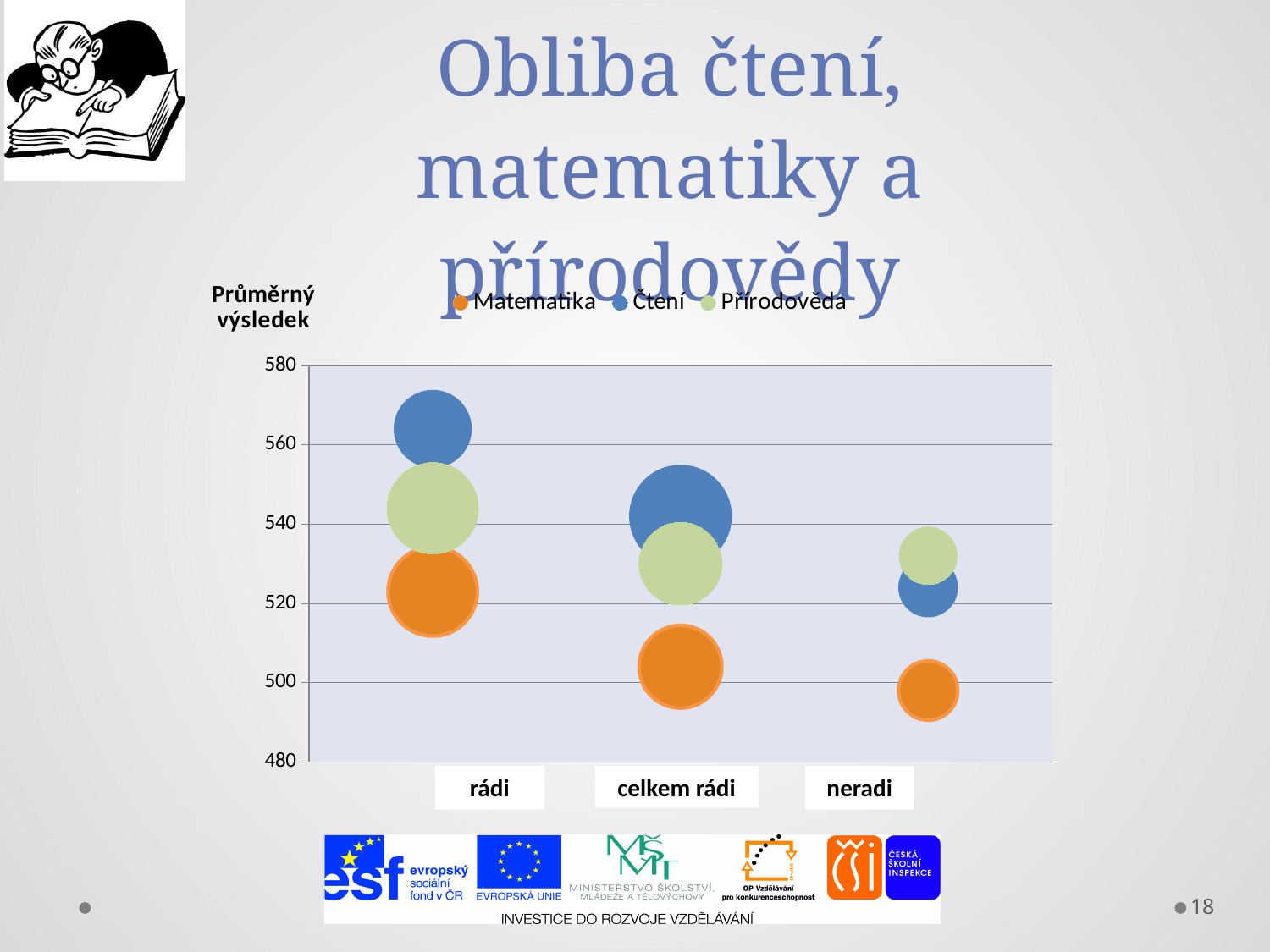
In which category is the Matematika value lowest? neradi How many series does the legend list? 3 Is the value for Čtení in the rádi category greater or less than 560? greater Is the value for Přírodověda in the neradi category greater or less than 520? greater Is the value for Matematika in the celkem rádi category greater or less than 520? less For the rádi category, which is larger: Čtení or Matematika? Čtení Which series is shown in orange? Matematika Do the Matematika values rise or fall from rádi to neradi? fall What kind of chart is shown on the slide? bubble chart What is the label of the vertical axis? Průměrný výsledek How many categories are shown on the x axis? 3